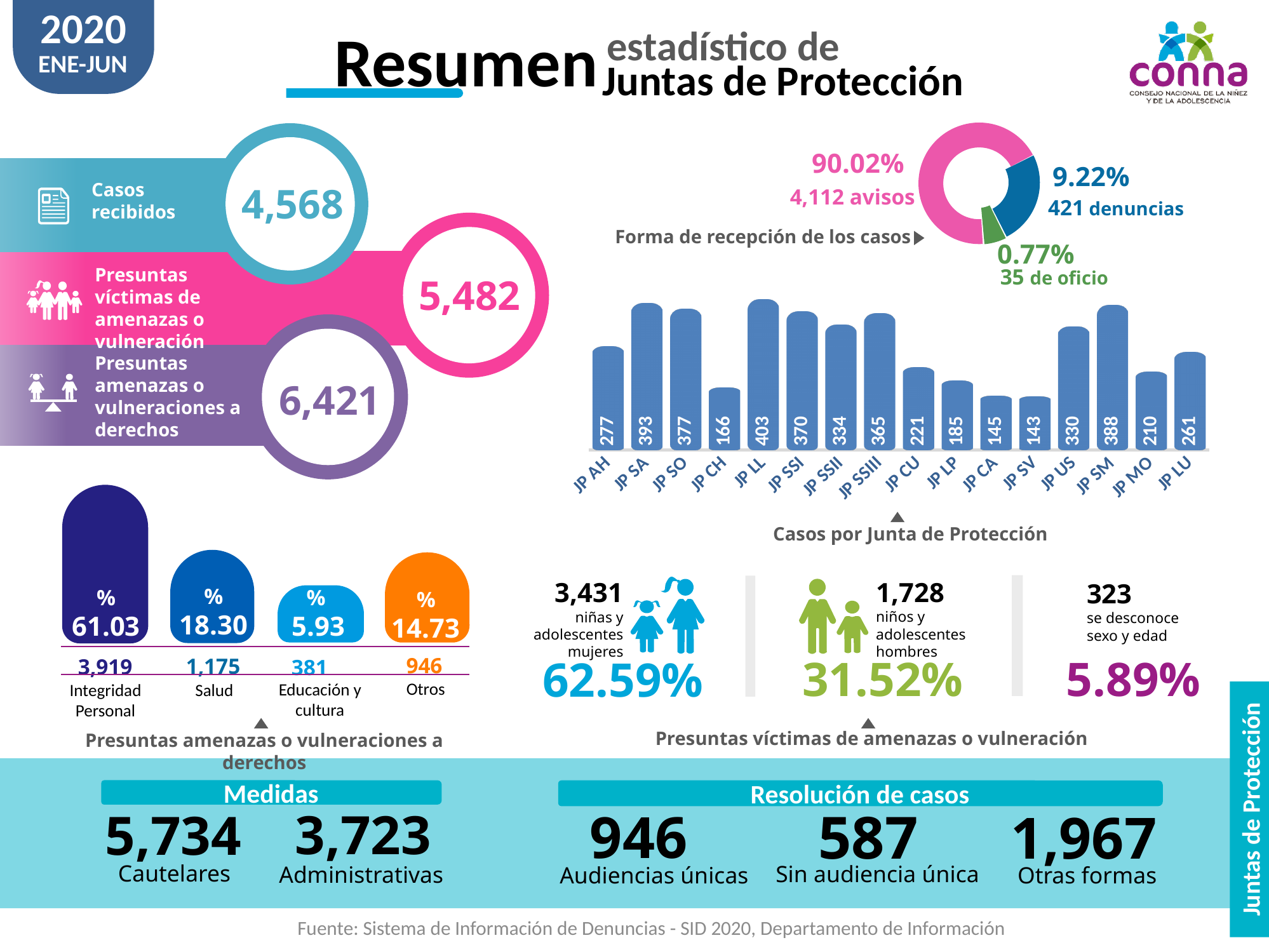
In the 'Forma de recepción de los casos' donut chart, what share of cases were received as avisos? 90.02% In the 'Presuntas amenazas o vulneraciones a derechos' bar chart, what is the value for Salud? 1,175 In the 'Casos por Junta de Protección' bar chart, which is larger, JP CU or JP LU? JP LU In the 'Casos por Junta de Protección' bar chart, which Junta has the highest number of cases? JP LL In the 'Forma de recepción de los casos' donut chart, which category has the smallest share? de oficio In the 'Casos por Junta de Protección' bar chart, what is the value for JP SA? 393 In the 'Presuntas amenazas o vulneraciones a derechos' bar chart, what percentage corresponds to Integridad Personal? 61.03% In the 'Forma de recepción de los casos' donut chart, how many cases were denuncias? 421 What kind of chart is 'Casos por Junta de Protección'? Bar chart In the 'Casos por Junta de Protección' bar chart, how many Juntas de Protección are shown? 16 In the 'Casos por Junta de Protección' bar chart, what is the difference between JP SM and JP MO? 178 In the 'Presuntas amenazas o vulneraciones a derechos' bar chart, how many categories are shown? 4